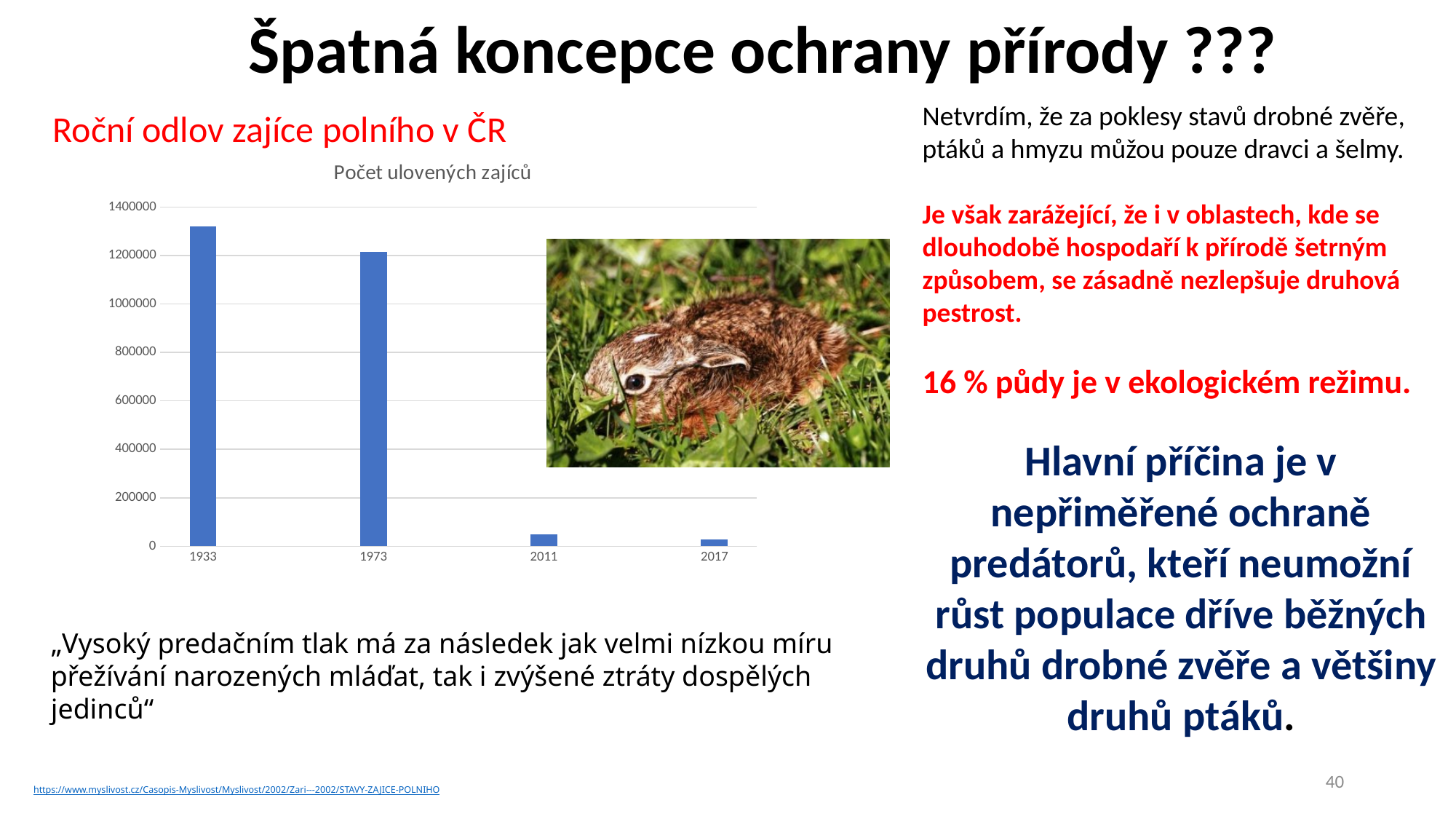
Which year has the lowest number of hunted hares in the chart? 2017 Is the value for 1933 greater or less than 1200000? greater Which year has the highest number of hunted hares in the chart? 1933 Is the value for 1973 greater or less than 1400000? less Is the value for 1973 greater or less than 1000000? greater What is the highest value shown on the y axis of the chart? 1400000 Do the values in the chart rise or fall from 1933 to 2017? fall How many years are shown on the x axis of the chart? 4 What is the title of the chart? Počet ulovených zajíců What kind of chart is shown on the slide? bar chart Which is larger, the value for 1933 or the value for 1973? 1933